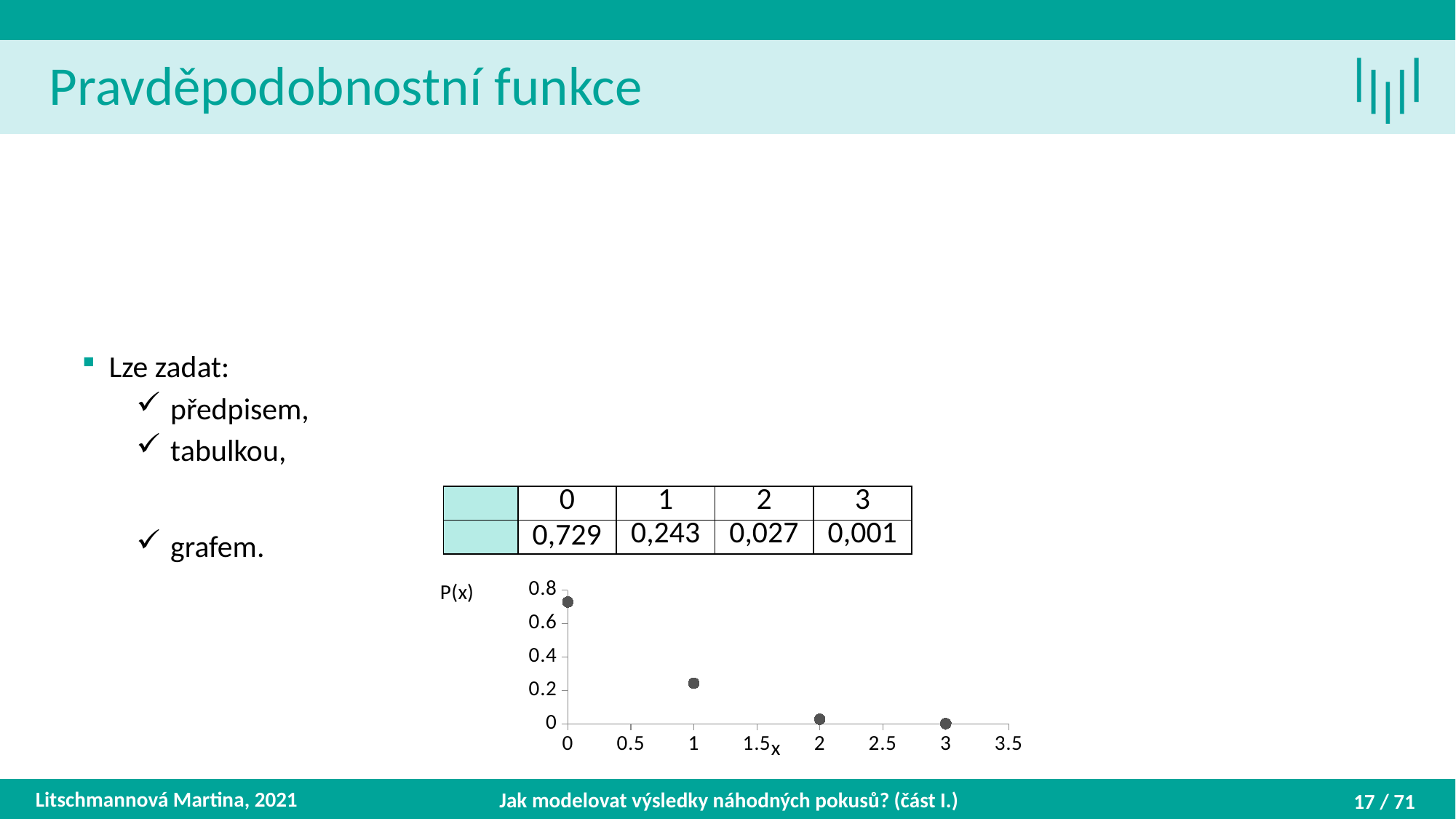
What kind of chart is shown on the slide? scatter chart How many data points are plotted in the chart? 4 Do the plotted values of P(x) rise or fall as x increases? fall What is the label of the vertical axis of the chart? P(x) Is the value of P(x) at x = 1 greater or less than 0.4? less Which has the larger P(x) value, x = 1 or x = 2? x = 1 Is the value of P(x) at x = 2 greater or less than 0.2? less At which value of x is P(x) lowest in the chart? 3 Using the table values, what is the difference between P(x) at x = 0 and at x = 1? 0,486 According to the table above the chart, what is the value of P(x) at x = 0? 0,729 At which value of x is P(x) highest in the chart? 0 Is the value of P(x) at x = 0 greater or less than 0.6? greater